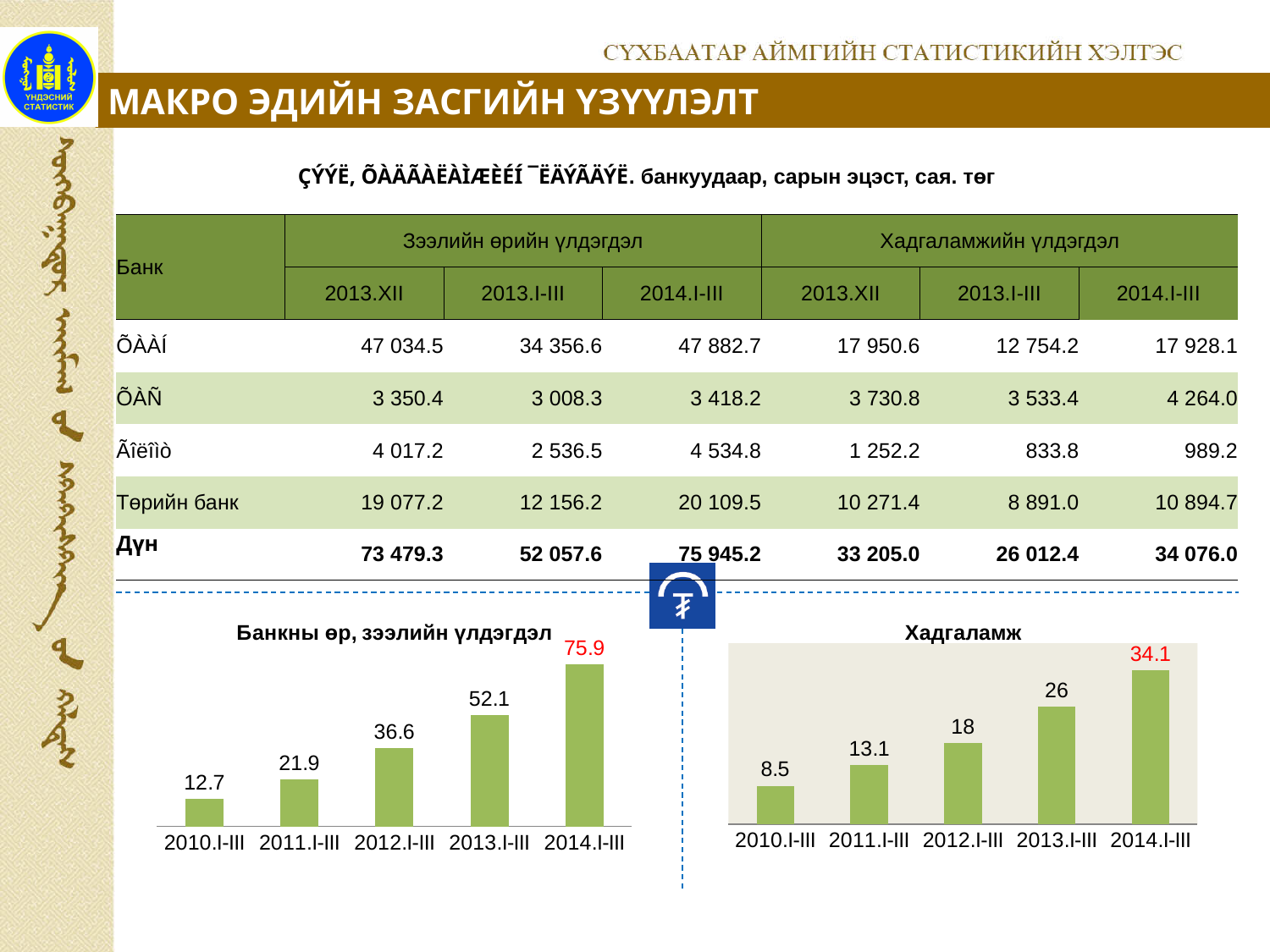
How many bars are shown in the chart titled "Банкны өр, зээлийн үлдэгдэл"? 5 In the chart titled "Хадгаламж", what is the value for 2012.I-III? 18 What type of chart is the chart titled "Хадгаламж"? Bar chart In the chart titled "Банкны өр, зээлийн үлдэгдэл", what is the value for 2014.I-III? 75.9 In the chart titled "Банкны өр, зээлийн үлдэгдэл", what is the value for 2011.I-III? 21.9 In the chart titled "Хадгаламж", what is the value for 2010.I-III? 8.5 In the chart titled "Банкны өр, зээлийн үлдэгдэл", do the values rise or fall from 2010.I-III to 2014.I-III? Rise In the chart titled "Хадгаламж", which period has the highest value? 2014.I-III In the chart titled "Банкны өр, зээлийн үлдэгдэл", what is the difference between the values for 2014.I-III and 2013.I-III? 23.8 In the chart titled "Хадгаламж", which is larger, the value for 2011.I-III or the value for 2012.I-III? 2012.I-III In the chart titled "Банкны өр, зээлийн үлдэгдэл", which period has the lowest value? 2010.I-III In the chart titled "Хадгаламж", what is the difference between the values for 2013.I-III and 2012.I-III? 8